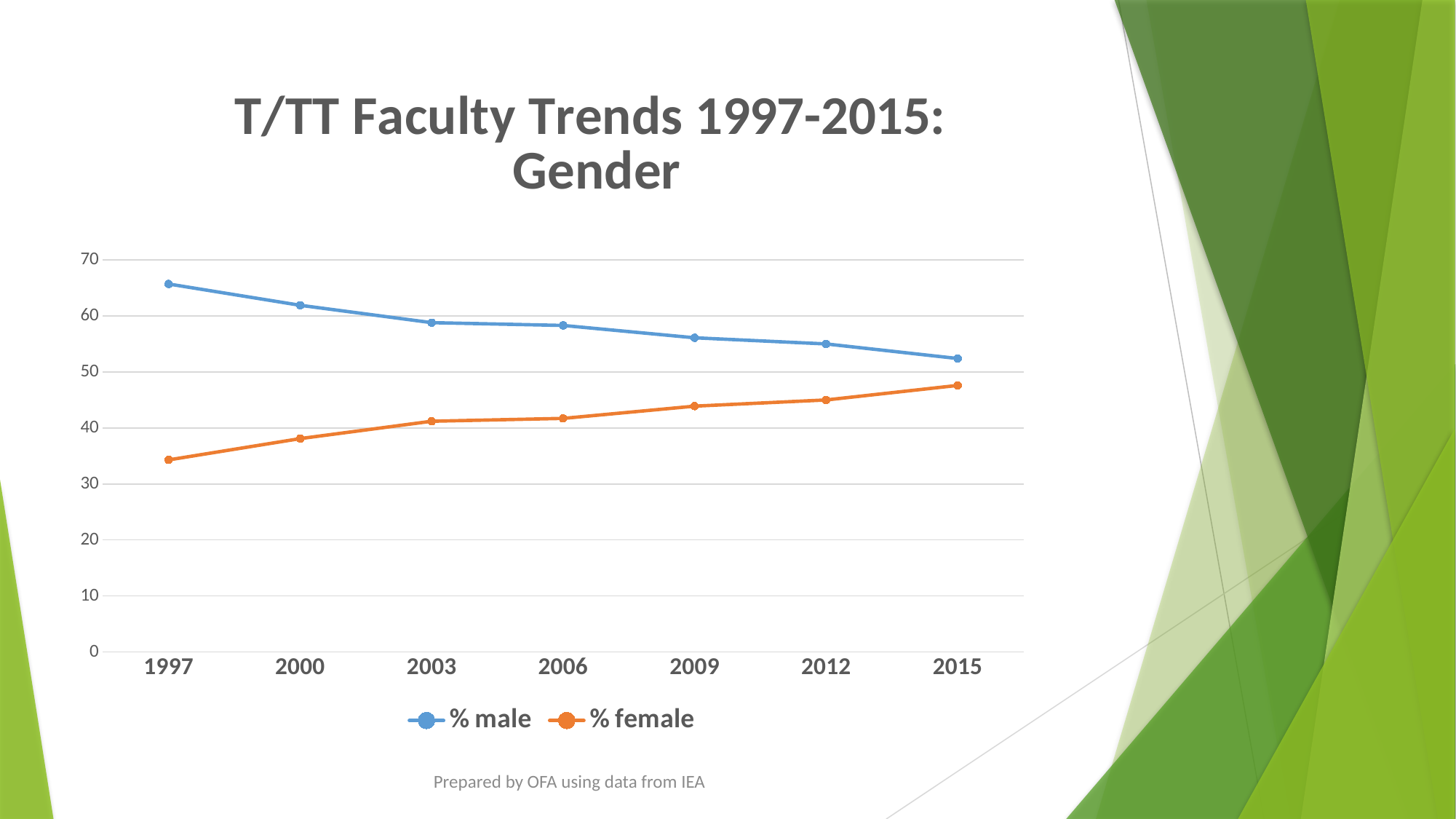
In which year is the % female value lowest? 1997 What colour is the line for % female? orange Is the value for % female in 2015 greater or less than 50? less Is the value for % male in 1997 greater or less than 60? greater How many series does the legend list? 2 In which year is the % male value highest? 1997 In 2015, which is larger, % male or % female? % male How many years are plotted along the x axis? 7 In which year is the % female value highest? 2015 Does the % female series rise or fall from 1997 to 2015? rise What kind of chart is shown on the slide? line chart Does the % male series rise or fall from 1997 to 2015? fall